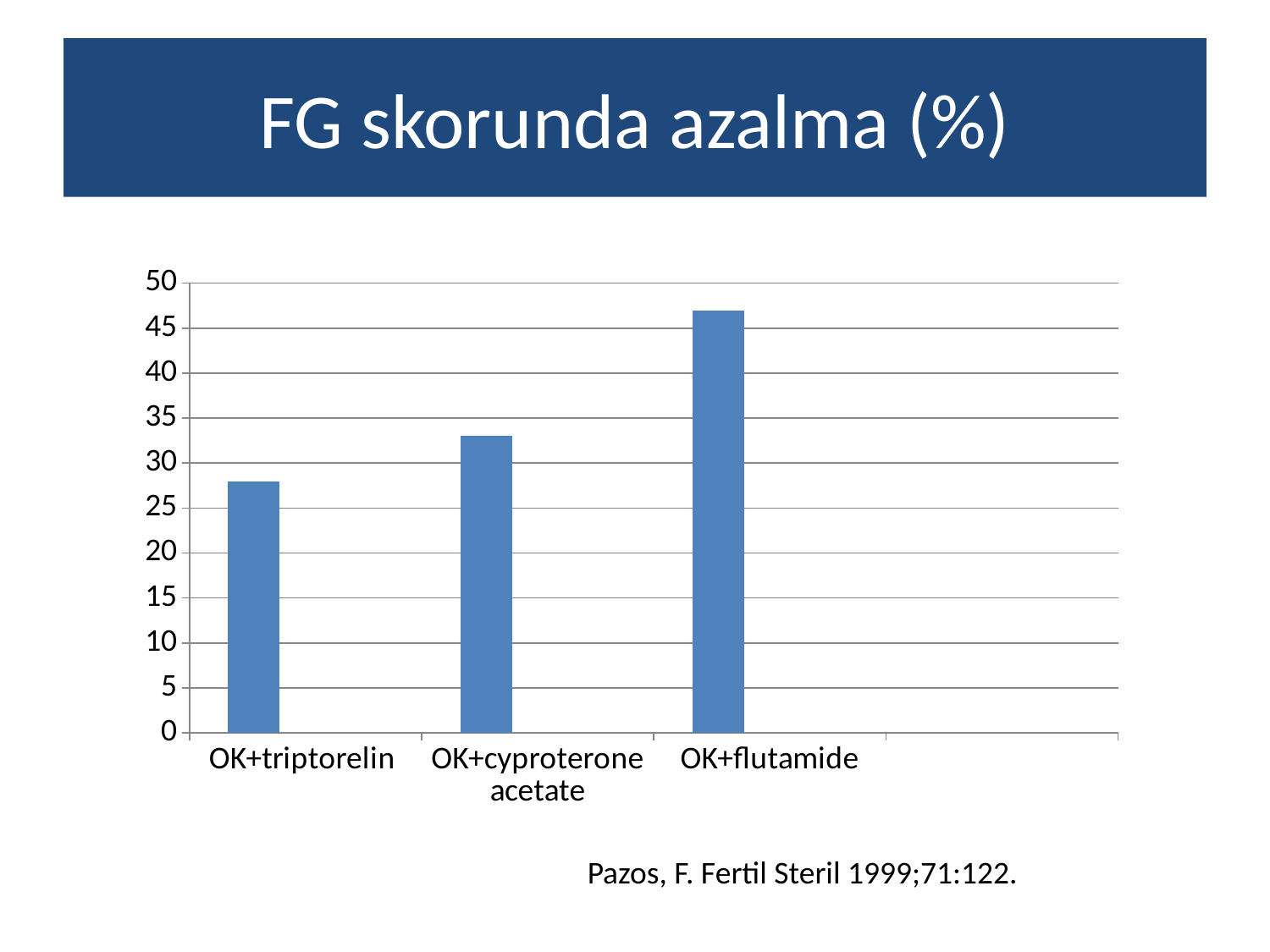
How many categories are plotted on the chart? 3 Which category has the lowest value? OK+triptorelin Is the value for OK+triptorelin greater or less than 25? greater What kind of chart is shown on the slide? bar chart Is the value for OK+flutamide greater or less than 45? greater Is the value for OK+triptorelin greater or less than 30? less What is the title of the slide containing the chart? FG skorunda azalma (%) Which is larger, the value for OK+cyproterone acetate or the value for OK+triptorelin? OK+cyproterone acetate Which is larger, the value for OK+flutamide or the value for OK+cyproterone acetate? OK+flutamide Do the values rise or fall from left to right across the categories? rise Which category has the highest value? OK+flutamide